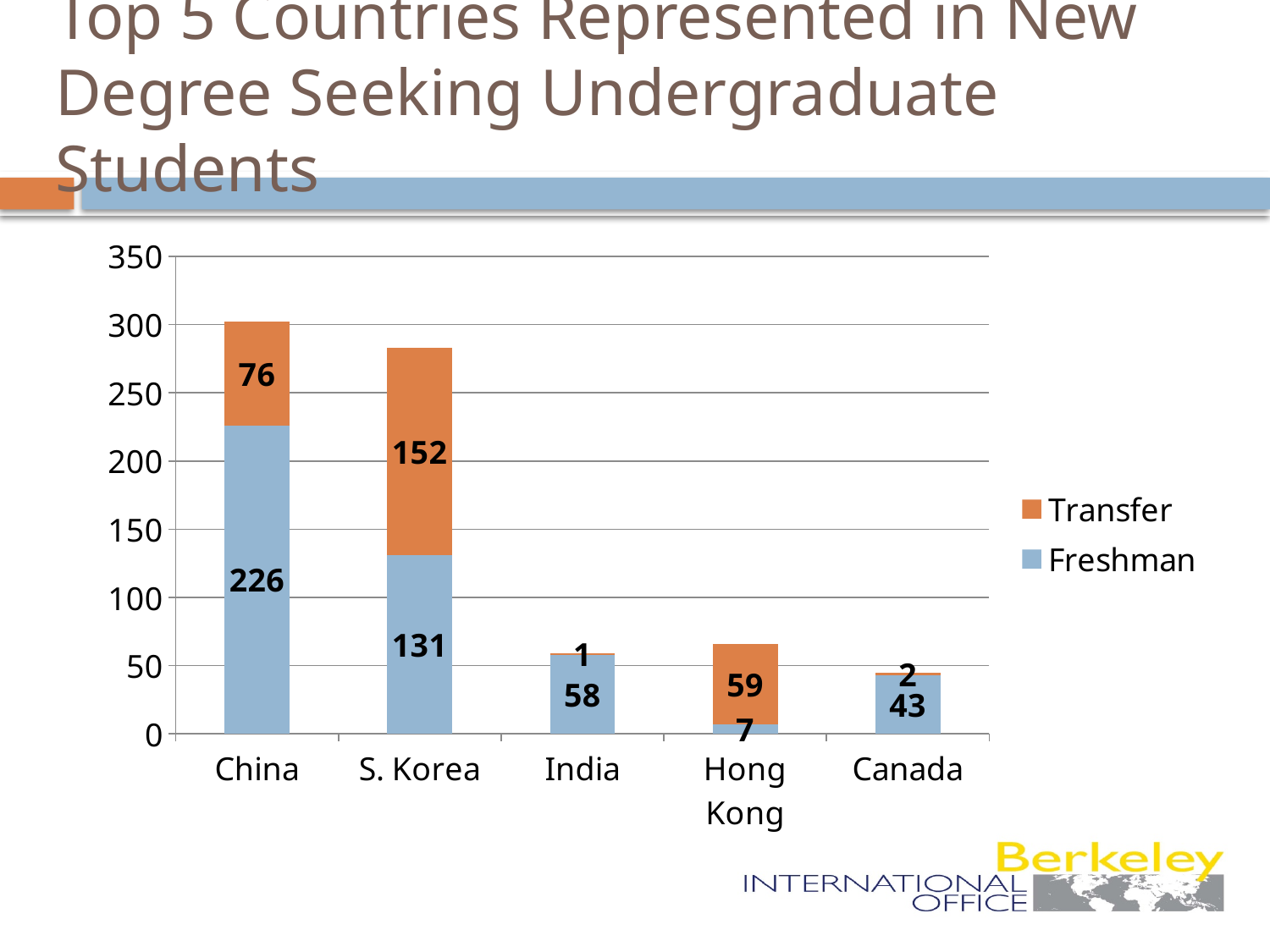
Which country has the lowest Transfer value? India What is the Freshman value for China? 226 What is the Freshman value for Hong Kong? 7 What is the total of the stacked bar for S. Korea? 283 Which is larger, the Transfer value for Hong Kong or the Transfer value for China? China How many countries are shown on the x axis? 5 What is the difference between the Freshman values for China and S. Korea? 95 What is the total of the stacked bar for Canada? 45 What is the Transfer value for S. Korea? 152 Which country has the highest Freshman value? China What kind of chart is shown on the slide? Stacked bar chart How many series does the legend list? 2